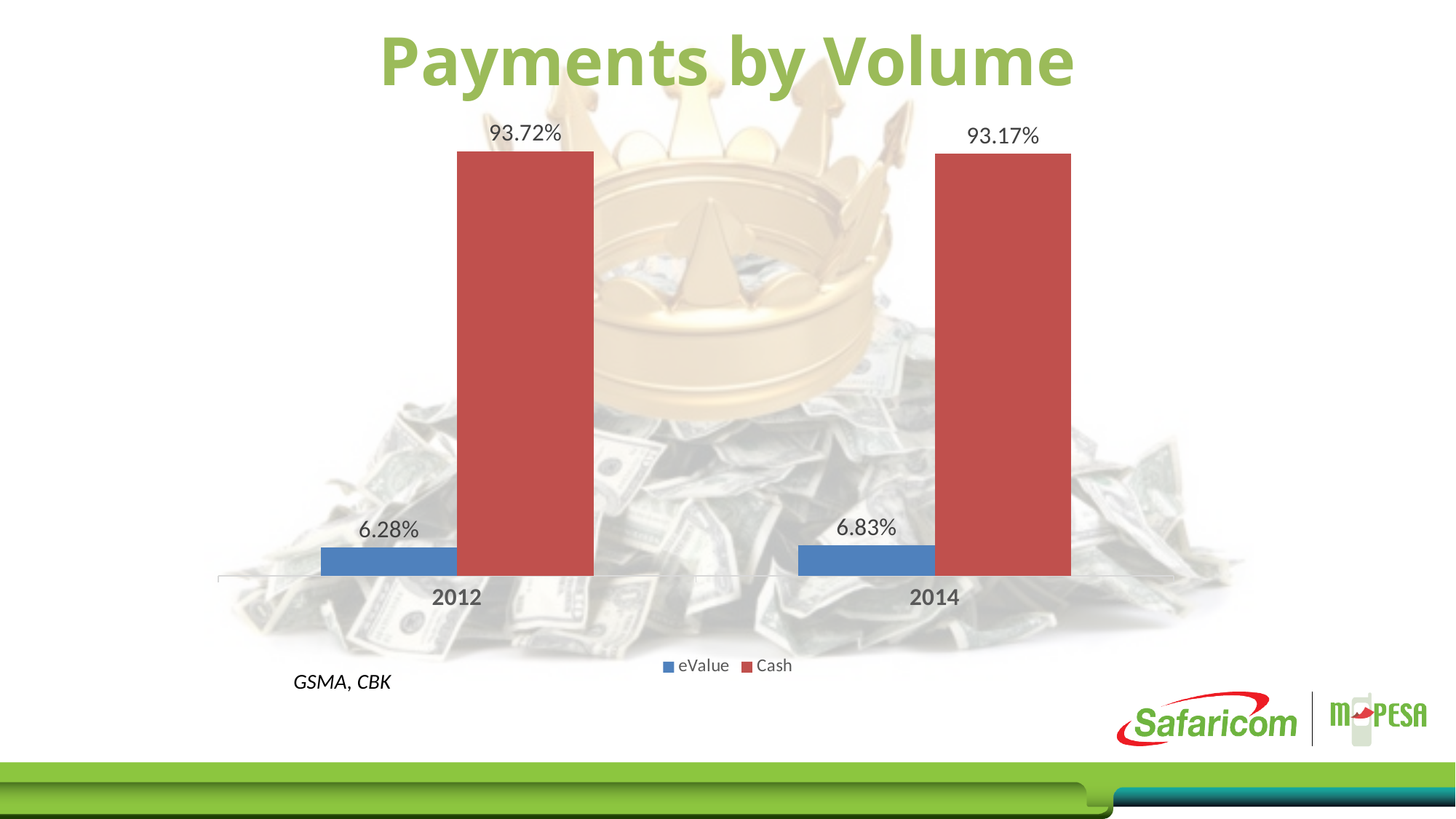
Does the eValue series rise or fall from 2012 to 2014? rise What is the Cash value for 2012? 93.72% What type of chart is shown on the slide? bar chart Does the Cash series rise or fall from 2012 to 2014? fall What is the eValue value for 2012? 6.28% Which series has the higher value in 2014, eValue or Cash? Cash What is the difference between the eValue values for 2014 and 2012? 0.55% How many series does the legend list? 2 What is the difference between the Cash values for 2012 and 2014? 0.55% What is the Cash value for 2014? 93.17% What is the eValue value for 2014? 6.83% How many years are shown on the x axis? 2